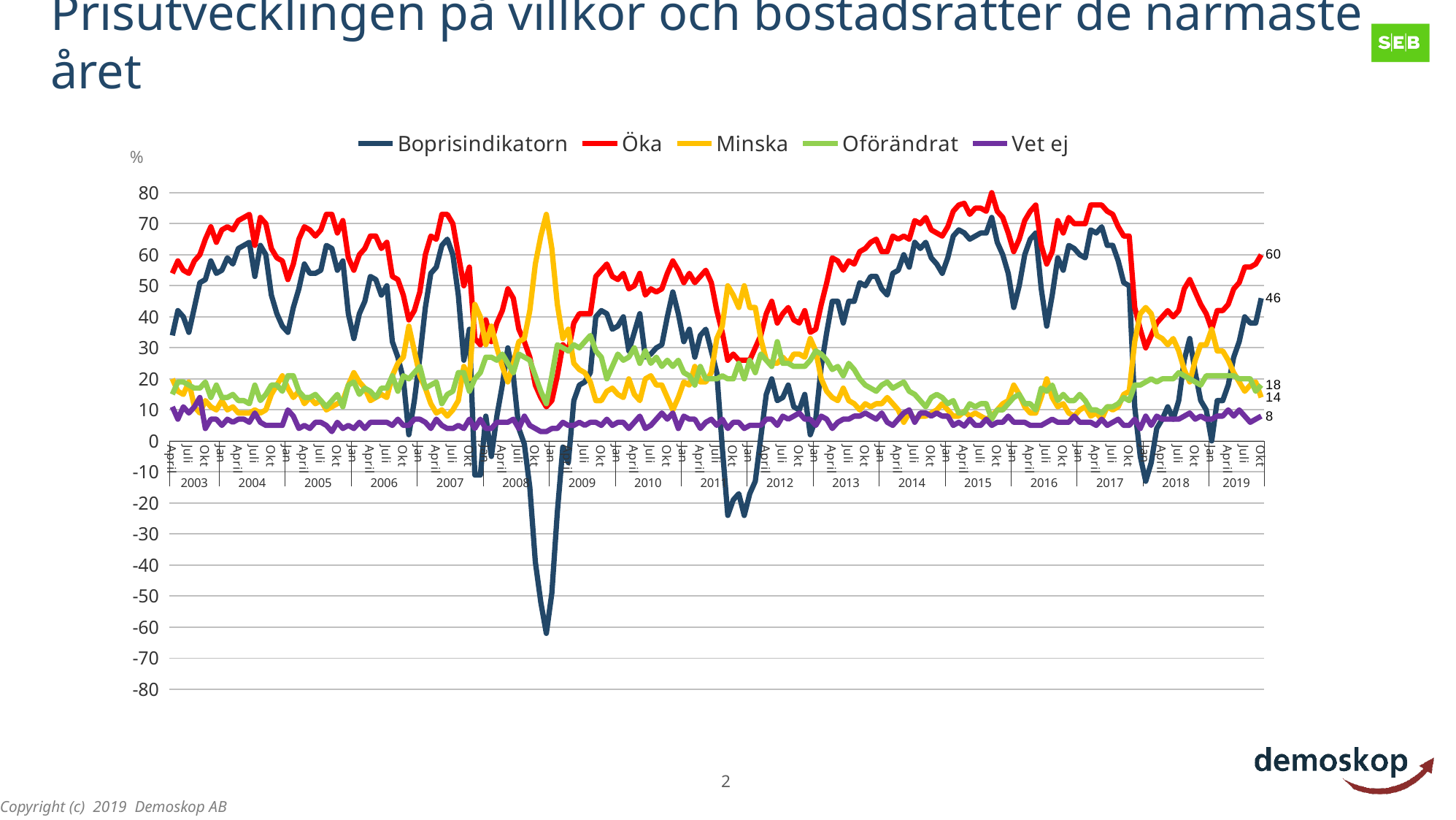
What is the final labelled value of the Boprisindikatorn series at the right end of the chart? 46 What is the final labelled value of the Vet ej series at the right end of the chart? 8 What kind of chart is shown on the slide? line chart Is the lowest point of the Boprisindikatorn series, around early 2009, greater or less than -50? less At the right end of the chart, which is larger: the Oförändrat value or the Minska value? Oförändrat What is the final labelled value of the Minska series at the right end of the chart? 14 Which series is drawn in red in the legend? Öka Which series has the highest labelled value at the right end of the chart? Öka What is the final labelled value of the Öka series at the right end of the chart? 60 What is the difference between the final labelled values of Öka and Boprisindikatorn? 14 How many series does the legend list? 5 Which series has the lowest labelled value at the right end of the chart? Vet ej